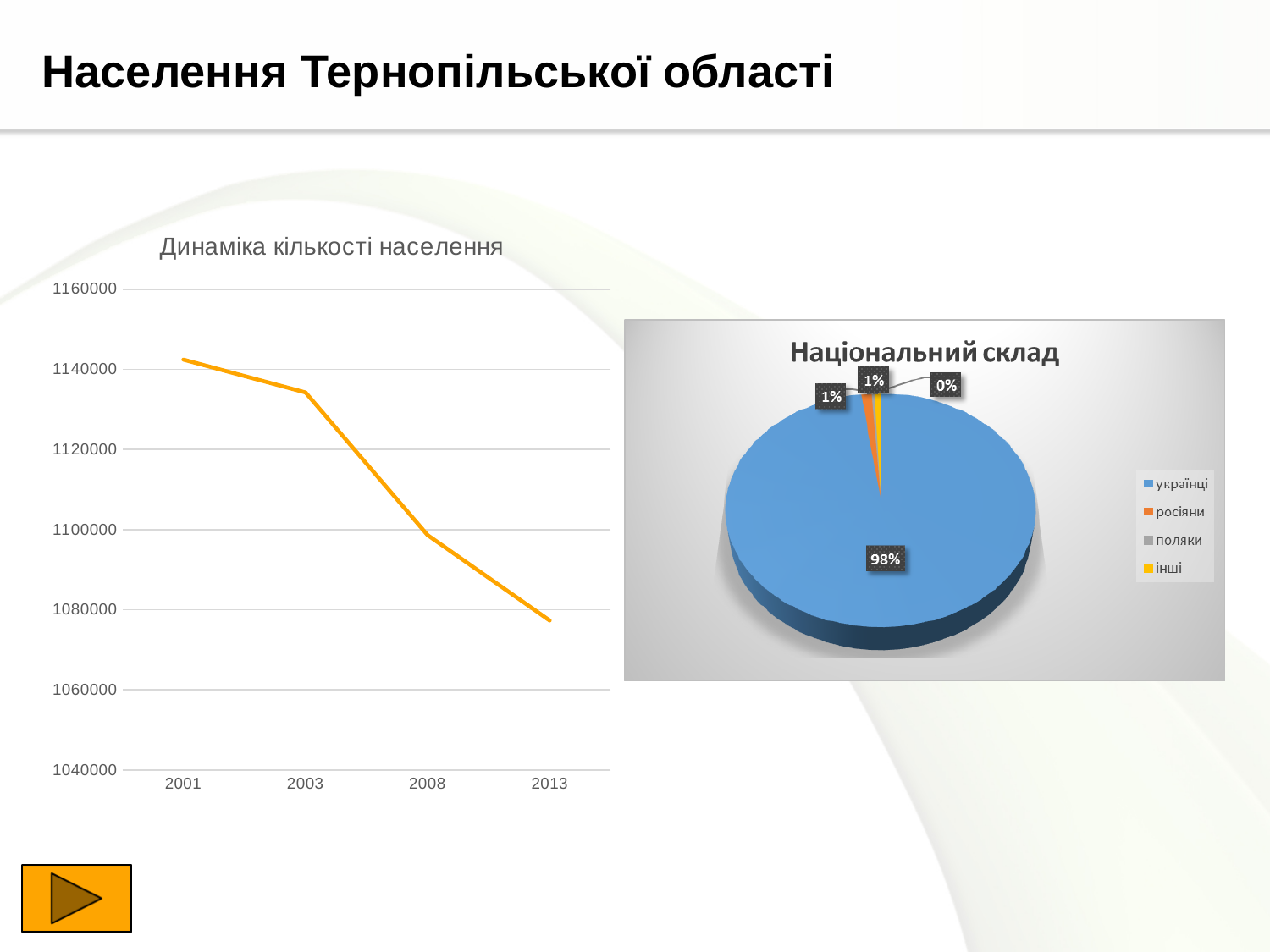
In the chart "Динаміка кількості населення", do the values rise or fall from 2001 to 2013? fall In the chart "Динаміка кількості населення", which year has the lowest population? 2013 In the chart "Динаміка кількості населення", which year has the highest population? 2001 In the chart "Динаміка кількості населення", is the value for 2008 greater or less than 1120000? less What kind of chart is "Динаміка кількості населення"? line chart In the chart "Динаміка кількості населення", which is larger, the value for 2001 or the value for 2008? 2001 What kind of chart is "Національний склад"? pie chart In the chart "Динаміка кількості населення", how many years are plotted on the x axis? 4 How many entries does the legend of the chart "Національний склад" list? 4 In the chart "Національний склад", what share of the pie is українці? 98% In the chart "Динаміка кількості населення", is the value for 2013 greater or less than 1100000? less In the chart "Динаміка кількості населення", is the value for 2003 greater or less than 1120000? greater